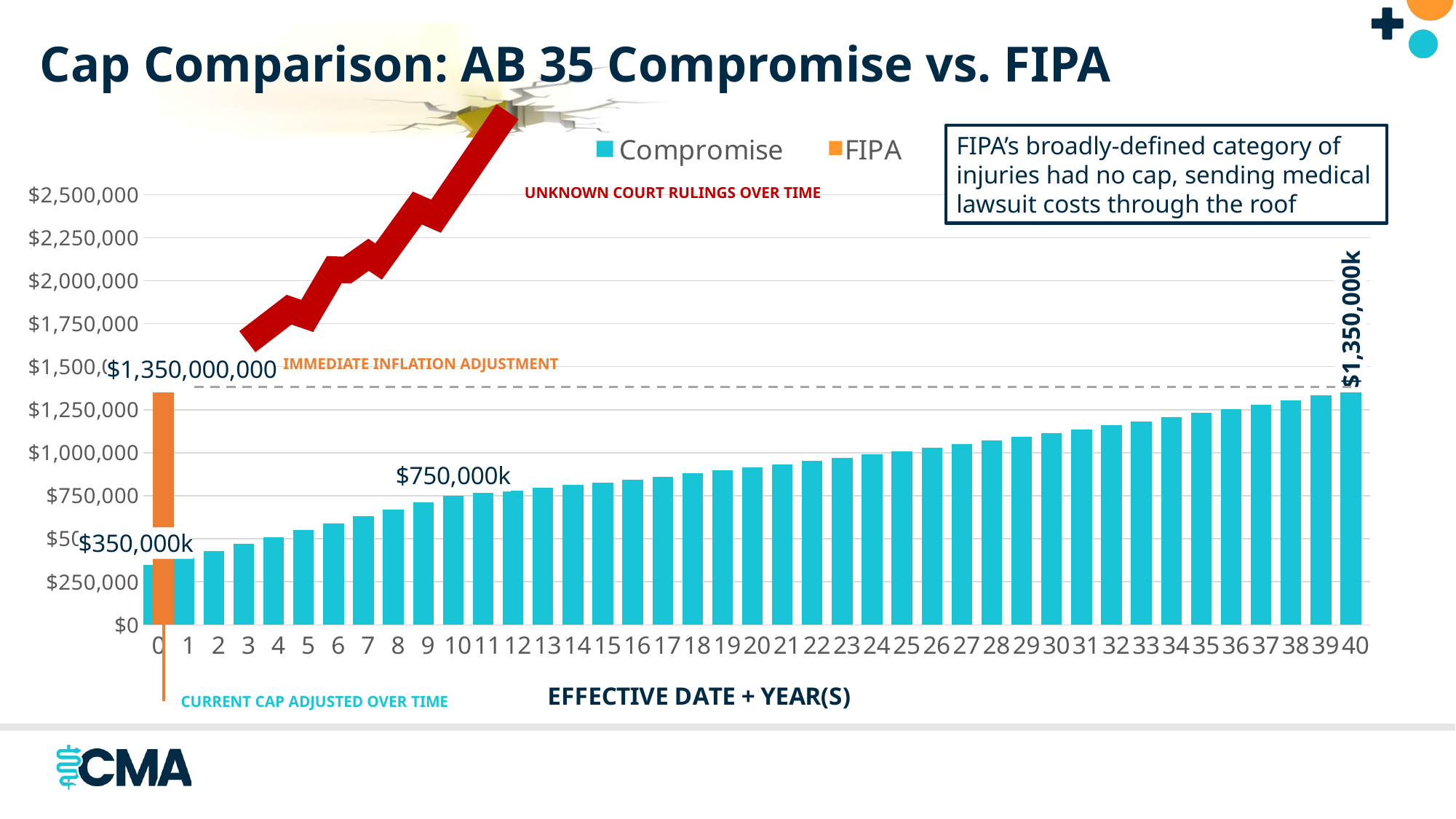
How many series does the chart legend list? 2 Is the Compromise value at year 20 greater or less than $1,000,000? less At which year is the Compromise bar lowest? 0 What type of chart is shown on the slide? bar chart Which two series are listed in the chart legend? Compromise and FIPA What is the labelled value of the Compromise bar at year 40? $1,350,000k At year 0, which bar is taller: Compromise or FIPA? FIPA At which year is the Compromise bar highest? 40 Do the Compromise values rise or fall as the years increase along the x axis? rise Is the Compromise value at year 30 greater or less than $1,000,000? greater What is the labelled value of the Compromise bar at year 10? $750,000k What is the labelled value of the Compromise bar at year 0? $350,000k